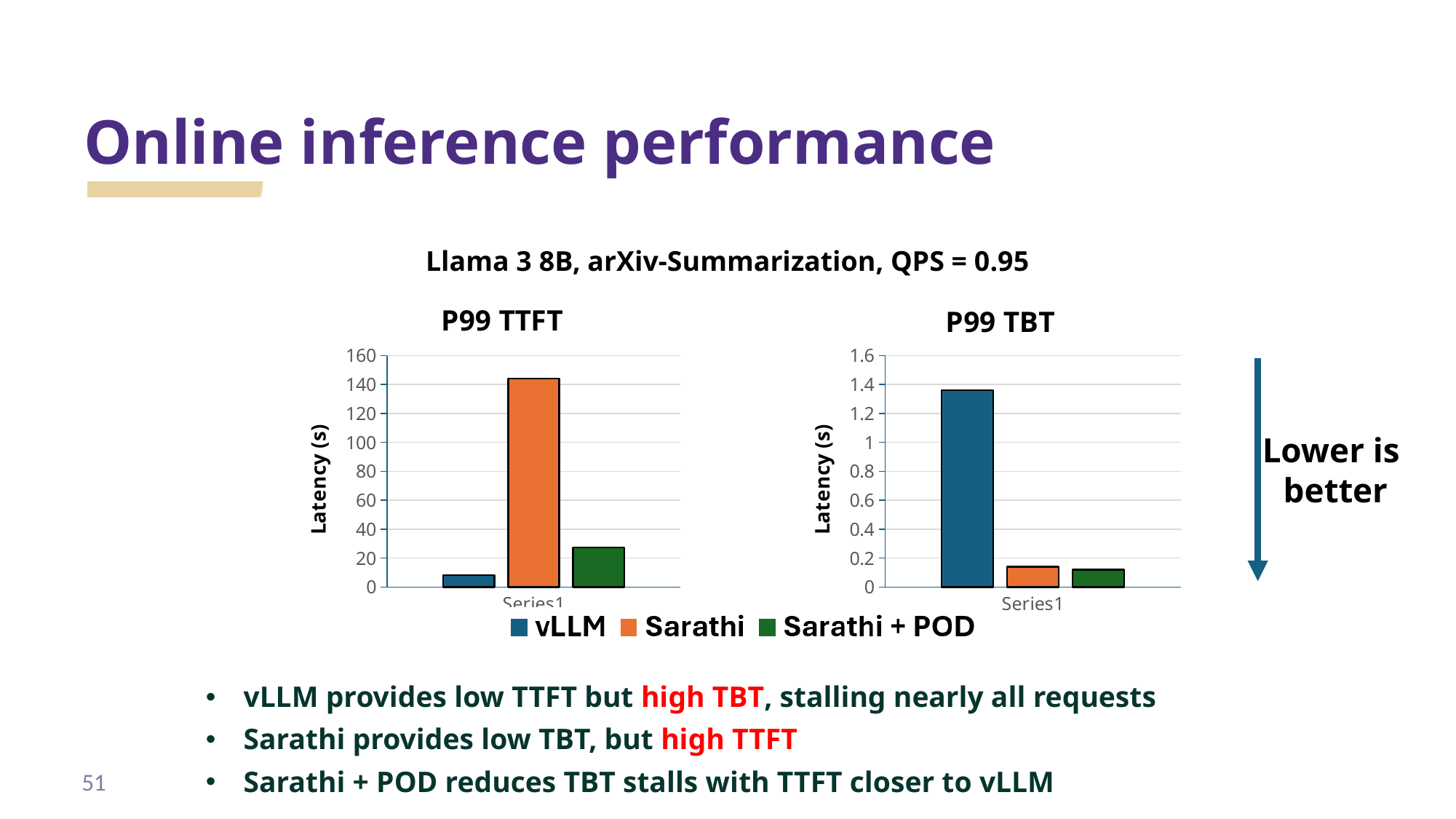
In the P99 TBT chart, is the value for vLLM greater or less than 1.2? greater In the P99 TBT chart, which series has the highest latency? vLLM What type of chart is the P99 TBT chart? Bar chart In the P99 TTFT chart, is the value for Sarathi + POD greater or less than 40? less In the P99 TTFT chart, which series has the lowest latency? vLLM In the P99 TTFT chart, is the value for Sarathi greater or less than 140? greater How many series does the shared legend list for the charts? 3 In the P99 TTFT chart, which is larger, the value for Sarathi + POD or the value for vLLM? Sarathi + POD In the P99 TBT chart, which is larger, the value for vLLM or the value for Sarathi + POD? vLLM In the P99 TTFT chart, which series has the highest latency? Sarathi